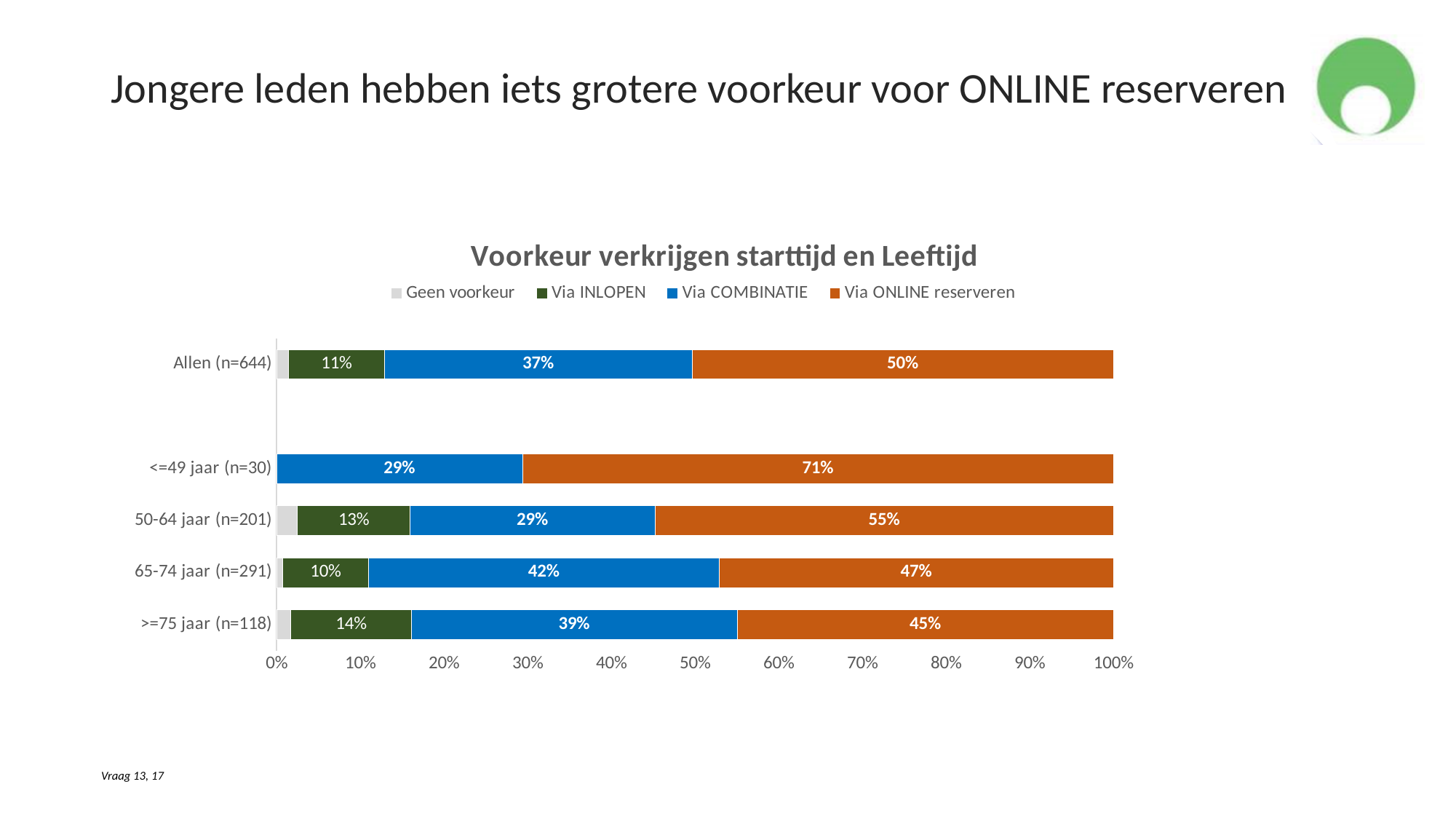
What is the difference between the Via ONLINE reserveren values for <=49 jaar (n=30) and >=75 jaar (n=118)? 26% What kind of chart is shown on the slide? Stacked bar chart How many age categories (including Allen) are shown on the chart? 5 What is the value for Via ONLINE reserveren in the Allen (n=644) category? 50% What is the value for Via INLOPEN in the >=75 jaar (n=118) category? 14% What is the title of the chart? Voorkeur verkrijgen starttijd en Leeftijd Which category has the highest value for Via ONLINE reserveren? <=49 jaar (n=30) What is the value for Via ONLINE reserveren in the <=49 jaar (n=30) category? 71% Which is larger: Via COMBINATIE for 65-74 jaar (n=291) or Via COMBINATIE for 50-64 jaar (n=201)? 65-74 jaar (n=291) Which category has the lowest value for Via ONLINE reserveren? >=75 jaar (n=118) How many series does the legend list? 4 What is the value for Via COMBINATIE in the 65-74 jaar (n=291) category? 42%